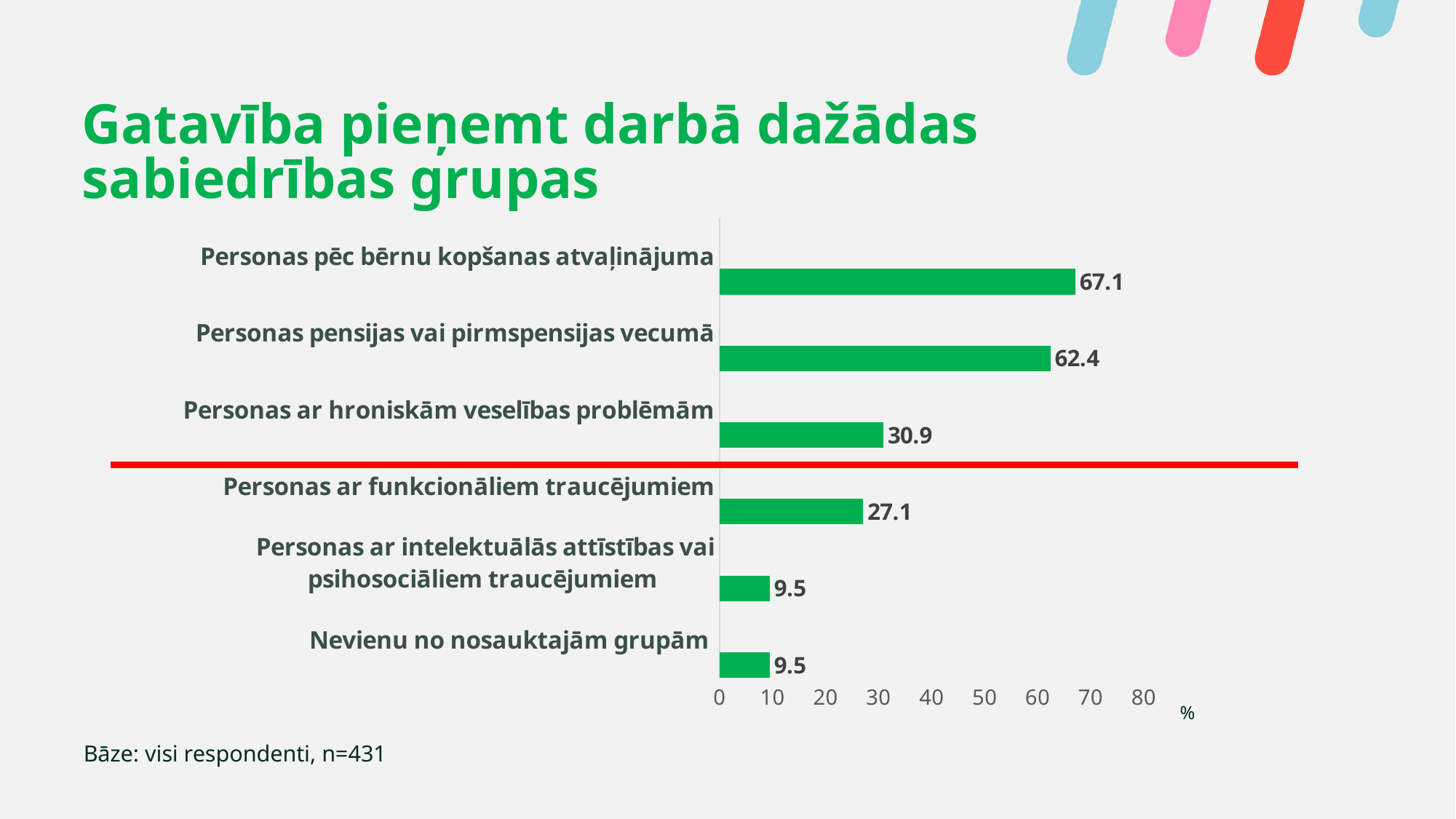
What is the value for "Personas ar hroniskām veselības problēmām"? 30.9 Which is larger, the value for "Personas pensijas vai pirmspensijas vecumā" or for "Personas ar hroniskām veselības problēmām"? Personas pensijas vai pirmspensijas vecumā What is the difference between the values for "Personas ar hroniskām veselības problēmām" and "Personas ar funkcionāliem traucējumiem"? 3.8 What kind of chart is shown on the slide? bar chart What is the base (sample size) stated below the chart? n=431 How many categories are shown in the chart? 6 What is the value for "Nevienu no nosauktajām grupām"? 9.5 What is the value for "Personas ar funkcionāliem traucējumiem"? 27.1 What is the difference between the values for "Personas pēc bērnu kopšanas atvaļinājuma" and "Personas pensijas vai pirmspensijas vecumā"? 4.7 Is the value for "Personas ar funkcionāliem traucējumiem" greater or less than 30? less What is the value for "Personas pēc bērnu kopšanas atvaļinājuma"? 67.1 Which category has the highest value? Personas pēc bērnu kopšanas atvaļinājuma